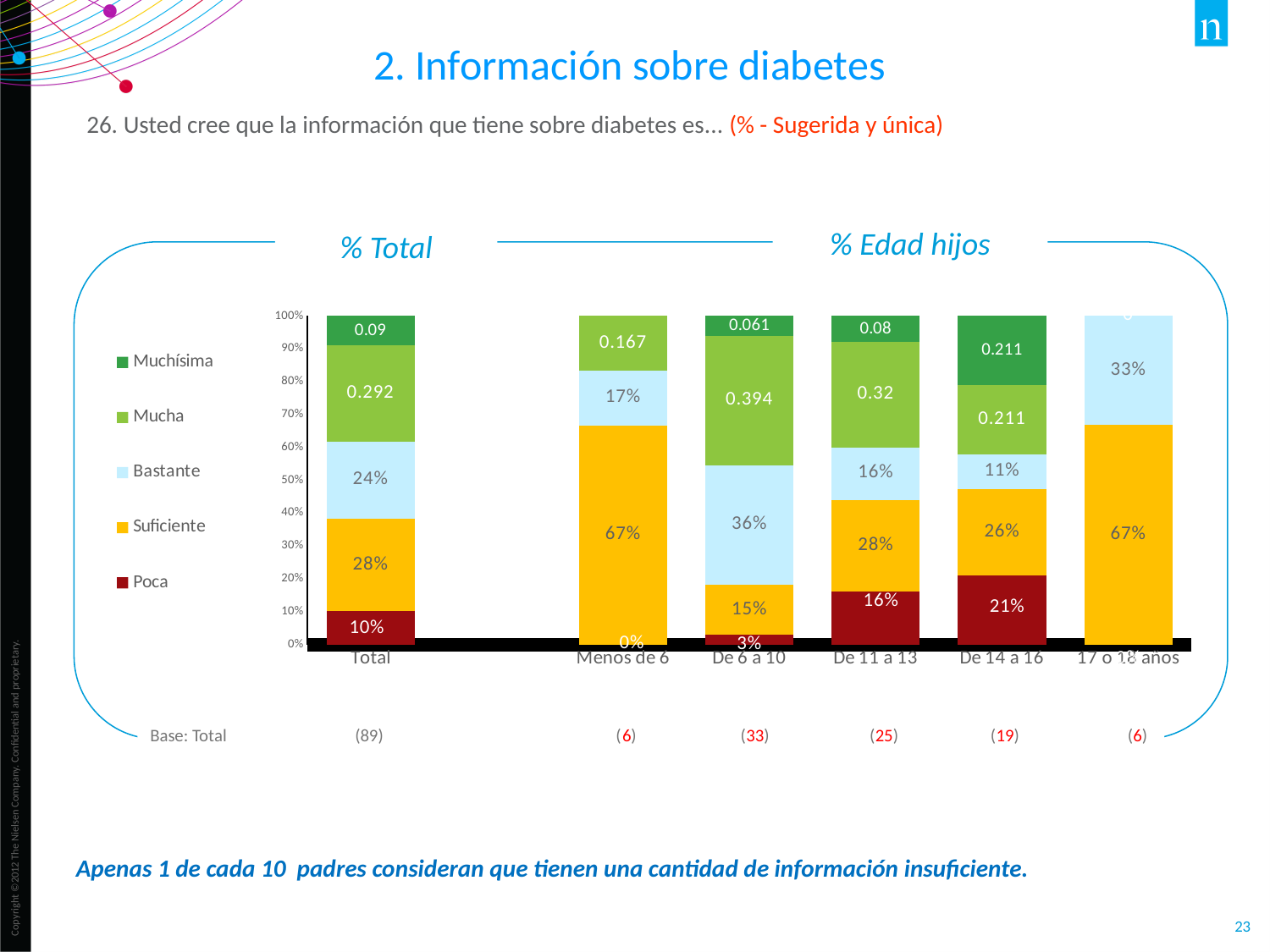
What is the value for Bastante in the De 6 a 10 category? 36% What is the value for Suficiente in the Menos de 6 category? 67% What type of chart is shown on the slide? stacked bar chart What is the difference between the Suficiente values for Menos de 6 and De 6 a 10? 52% What is the value for Mucha in the De 11 a 13 category? 0.32 Which is larger, the Bastante value for De 6 a 10 or for De 14 a 16? De 6 a 10 What is the value for Poca in the De 14 a 16 category? 21% How many series does the legend list? 5 Which category has the highest value for Poca? De 14 a 16 What is the value for Poca in the Total category? 10% How many categories are shown on the x axis? 6